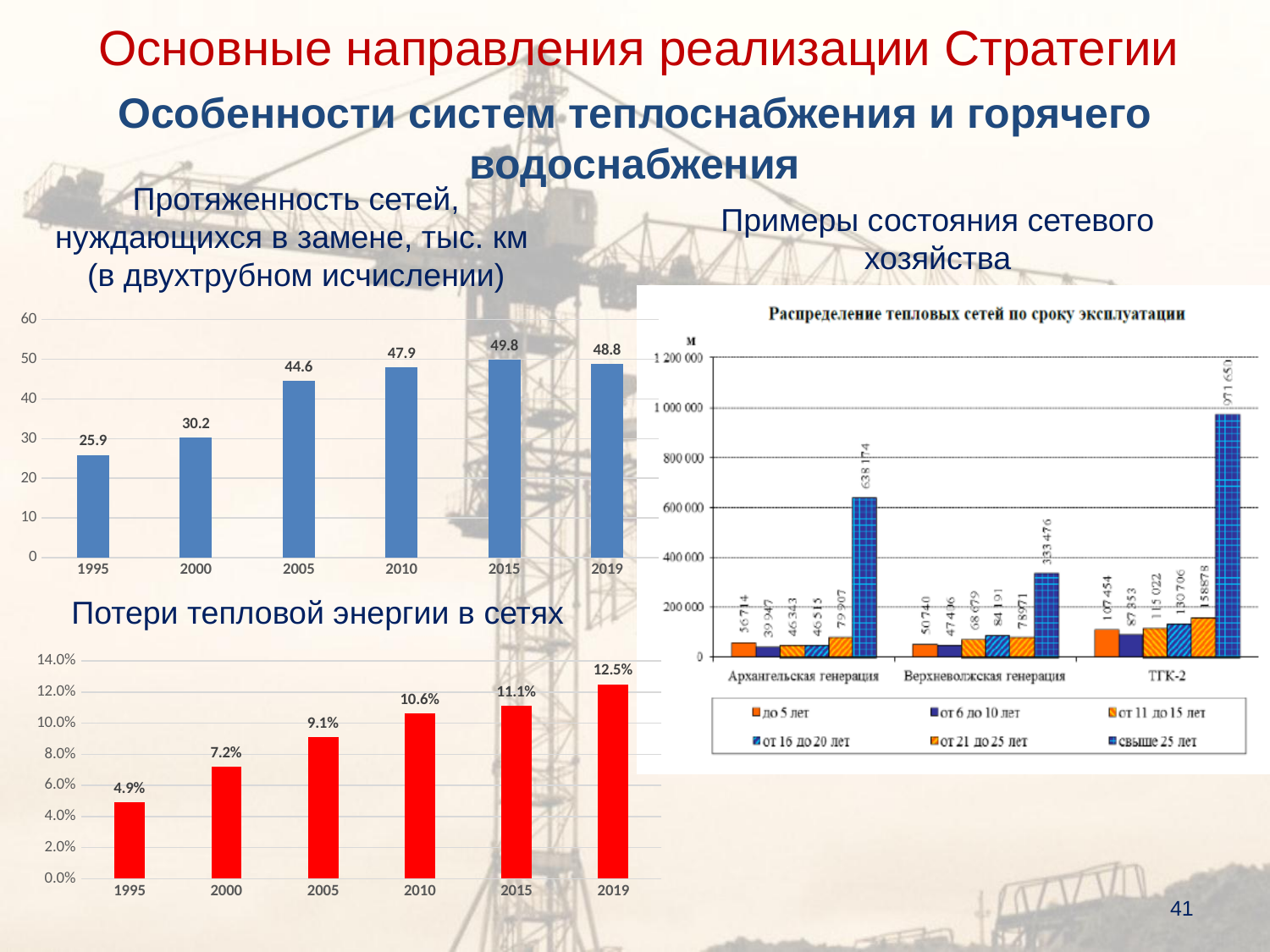
In the bottom-left chart (Потери тепловой энергии в сетях), what is the value for 1995? 4.9% In the top-left chart (Протяженность сетей, нуждающихся в замене), which year has the highest value? 2015 How many years are shown on the x axis of the top-left chart (Протяженность сетей, нуждающихся в замене)? 6 In the top-left chart (Протяженность сетей, нуждающихся в замене), what is the value for 2005? 44.6 In the right chart (Распределение тепловых сетей по сроку эксплуатации), which category has the highest value for the series 'свыше 25 лет'? ТГК-2 What kind of chart is the bottom-left chart (Потери тепловой энергии в сетях)? bar chart In the bottom-left chart (Потери тепловой энергии в сетях), what is the value for 2010? 10.6% In the right chart (Распределение тепловых сетей по сроку эксплуатации), how many series does the legend list? 6 In the right chart (Распределение тепловых сетей по сроку эксплуатации), is the value for 'свыше 25 лет' in Архангельская генерация greater or less than 400 000? greater In the top-left chart (Протяженность сетей, нуждающихся в замене), what is the difference between the values for 2019 and 1995? 22.9 In the top-left chart (Протяженность сетей, нуждающихся в замене), which year has the lowest value? 1995 In the bottom-left chart (Потери тепловой энергии в сетях), do the values rise or fall from 1995 to 2019? rise